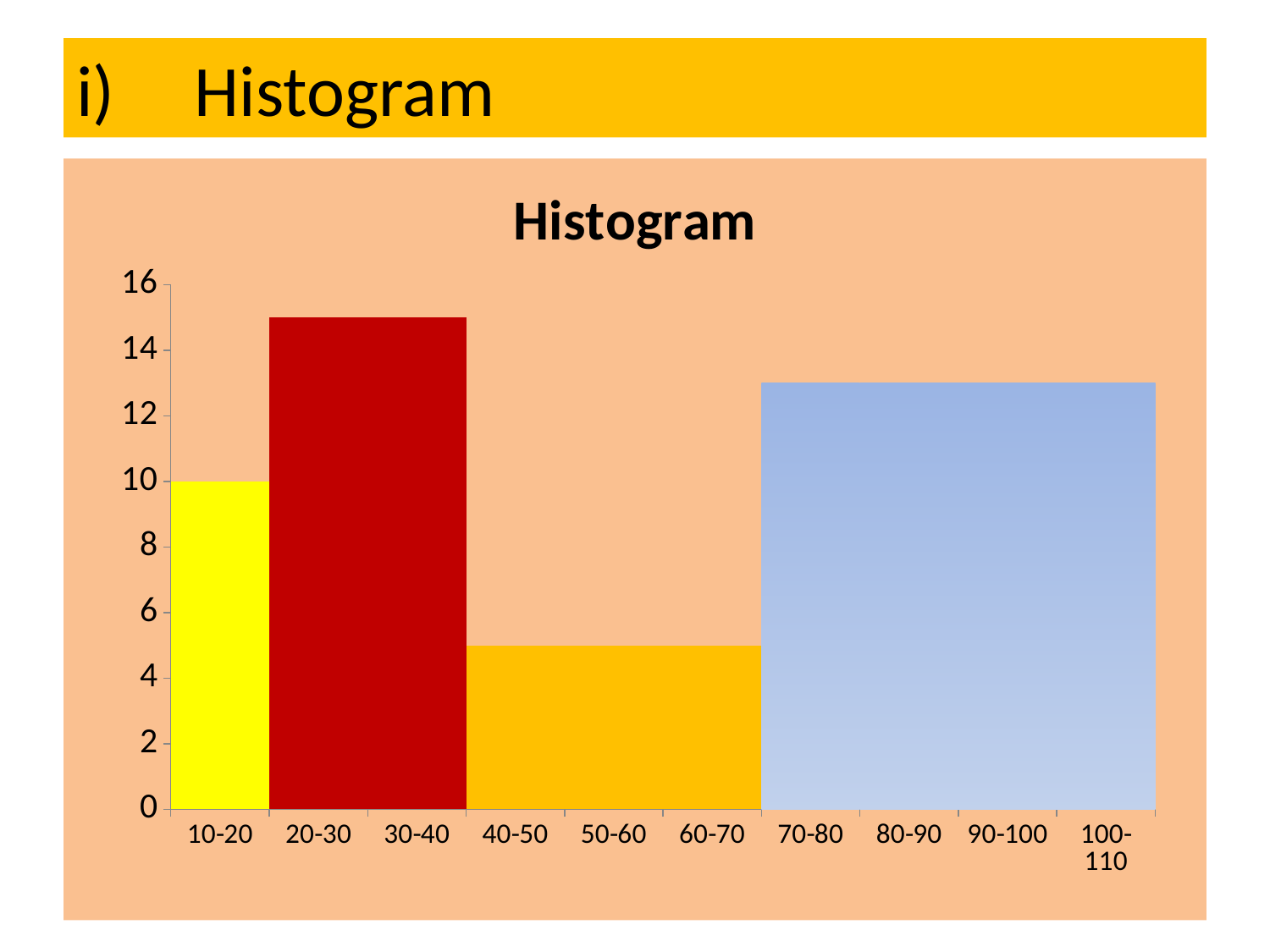
What is the value of the bar for the 10-20 class? 10 Is the value of the bar covering 70-80 greater or less than 12? greater Which bar is taller, the one for 10-20 or the one covering 70-80? 70-80 Which class interval has the tallest bar? 20-40 What colour is the tallest bar? red Is the value of the bar covering 40-50 greater or less than 6? less What kind of chart is shown on the slide? bar chart (histogram) Which bar is taller, the one for 10-20 or the one covering 40-50? 10-20 Which class interval has the shortest bar? 40-70 How many class labels are shown on the x axis? 10 Is the value of the bar covering 20-30 greater or less than 14? greater What is the title of the chart? Histogram